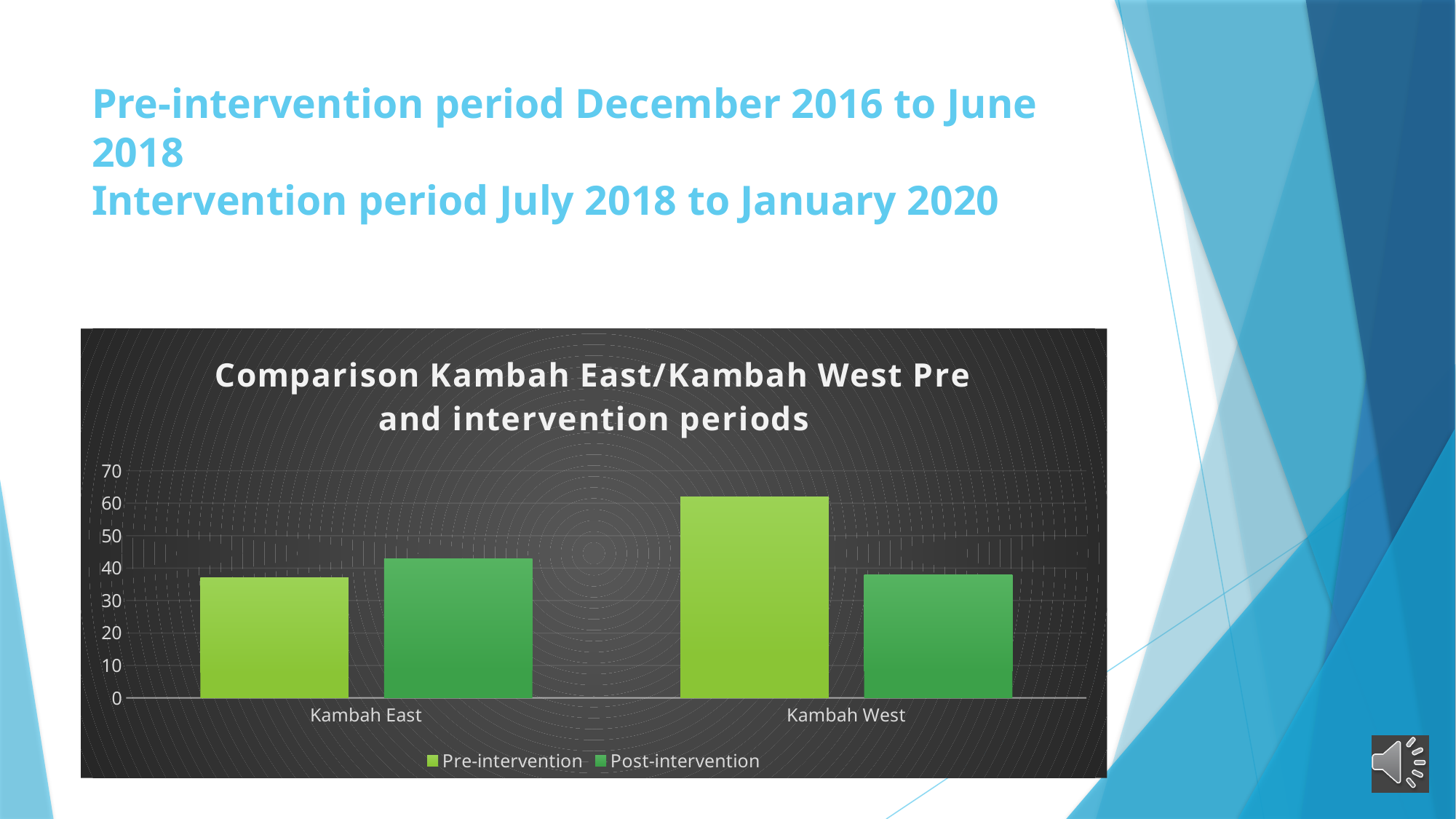
What type of chart is shown on the slide? bar chart Which bar is the highest in the chart? Kambah West Pre-intervention Is the Post-intervention value for Kambah West greater or less than 30? greater Which series is shown in the lighter green colour in the chart? Pre-intervention How many categories are shown on the x axis of the chart? 2 How many series does the chart legend list? 2 Is the Pre-intervention value for Kambah West greater or less than 50? greater For Kambah West, which is larger: the Pre-intervention value or the Post-intervention value? Pre-intervention What is the title of the chart? Comparison Kambah East/Kambah West Pre and intervention periods Does the Pre-intervention value rise or fall from Kambah East to Kambah West? rise Is the Pre-intervention value for Kambah East greater or less than 40? less For Kambah East, which is larger: the Pre-intervention value or the Post-intervention value? Post-intervention